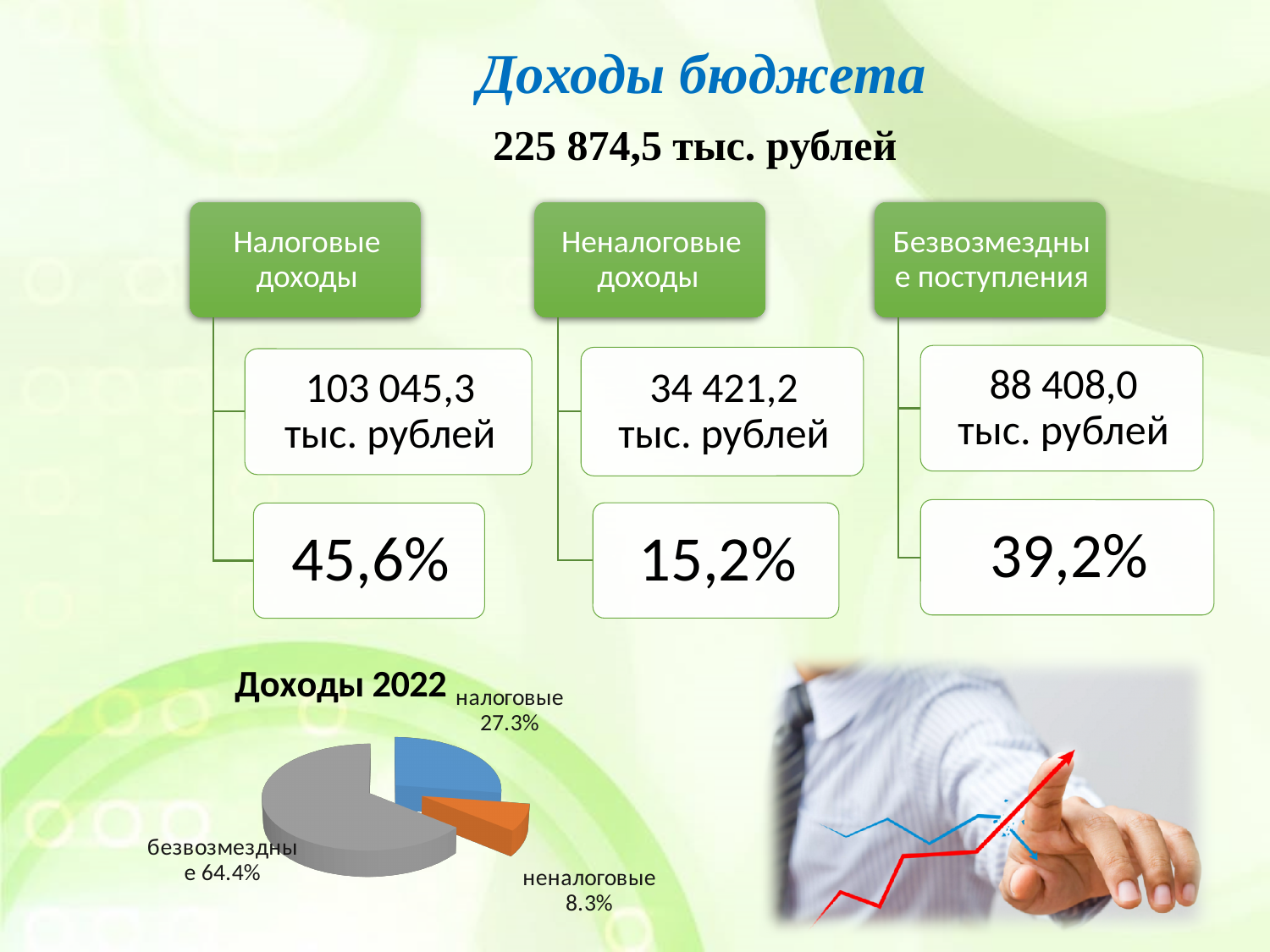
In the "Доходы 2022" pie chart, what share is labelled for "неналоговые"? 8.3% Which slice of the "Доходы 2022" pie chart is the smallest? неналоговые In the "Доходы 2022" pie chart, what share is labelled for "налоговые"? 27.3% In the "Доходы 2022" pie chart, what share is labelled for "безвозмездные"? 64.4% In the "Доходы 2022" pie chart, what is the difference in percentage points between the "налоговые" and "неналоговые" slices? 19.0 Which slice of the "Доходы 2022" pie chart is the largest? безвозмездные How many slices does the "Доходы 2022" pie chart have? 3 In the "Доходы 2022" pie chart, what colour is the "безвозмездные" slice? Grey What type of chart is shown under the title "Доходы 2022"? Pie chart In the "Доходы 2022" pie chart, what is the difference in percentage points between the "безвозмездные" and "налоговые" slices? 37.1 What is the title of the pie chart on the slide? Доходы 2022 In the "Доходы 2022" pie chart, which is larger: the "налоговые" slice or the "неналоговые" slice? налоговые